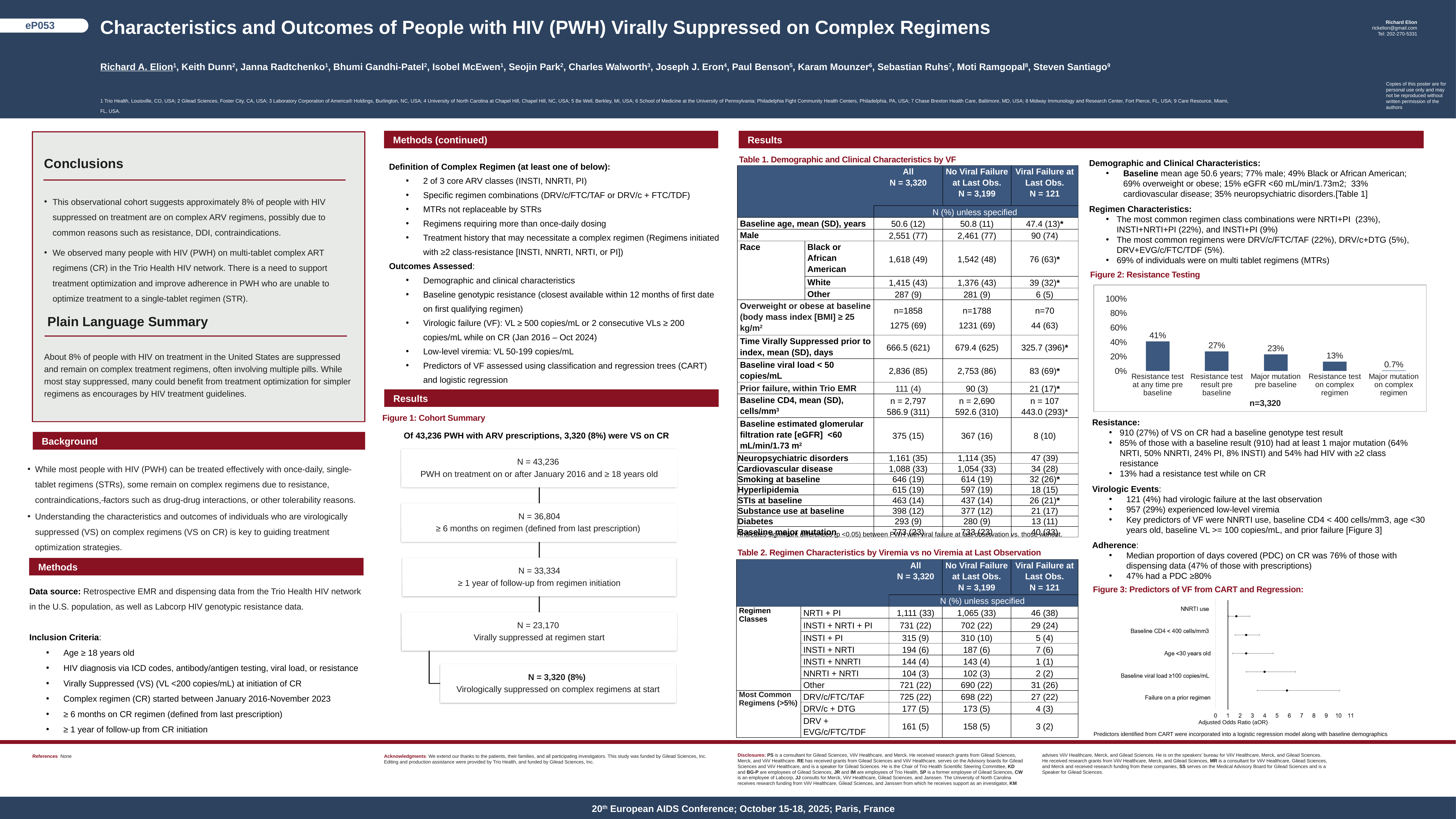
In Figure 2: Resistance Testing, what is the value for 'Major mutation on complex regimen'? 0.7% In Figure 2: Resistance Testing, is the value for 'Resistance test at any time pre baseline' greater or less than 60%? less What is the sample size (n) noted below the bars in Figure 2: Resistance Testing? n=3,320 In Figure 2: Resistance Testing, which category has the lowest value? Major mutation on complex regimen In Figure 2: Resistance Testing, which category has the highest value? Resistance test at any time pre baseline How many categories are shown in Figure 2: Resistance Testing? 5 In Figure 2: Resistance Testing, do the values rise or fall from left to right across the categories? Fall In Figure 2: Resistance Testing, what is the difference between 'Resistance test at any time pre baseline' and 'Resistance test result pre baseline'? 14% In Figure 2: Resistance Testing, which is larger: 'Major mutation pre baseline' or 'Resistance test on complex regimen'? Major mutation pre baseline In Figure 2: Resistance Testing, what is the value for 'Resistance test result pre baseline'? 27% What kind of chart is Figure 2: Resistance Testing? Bar chart In Figure 2: Resistance Testing, what is the value for 'Resistance test at any time pre baseline'? 41%